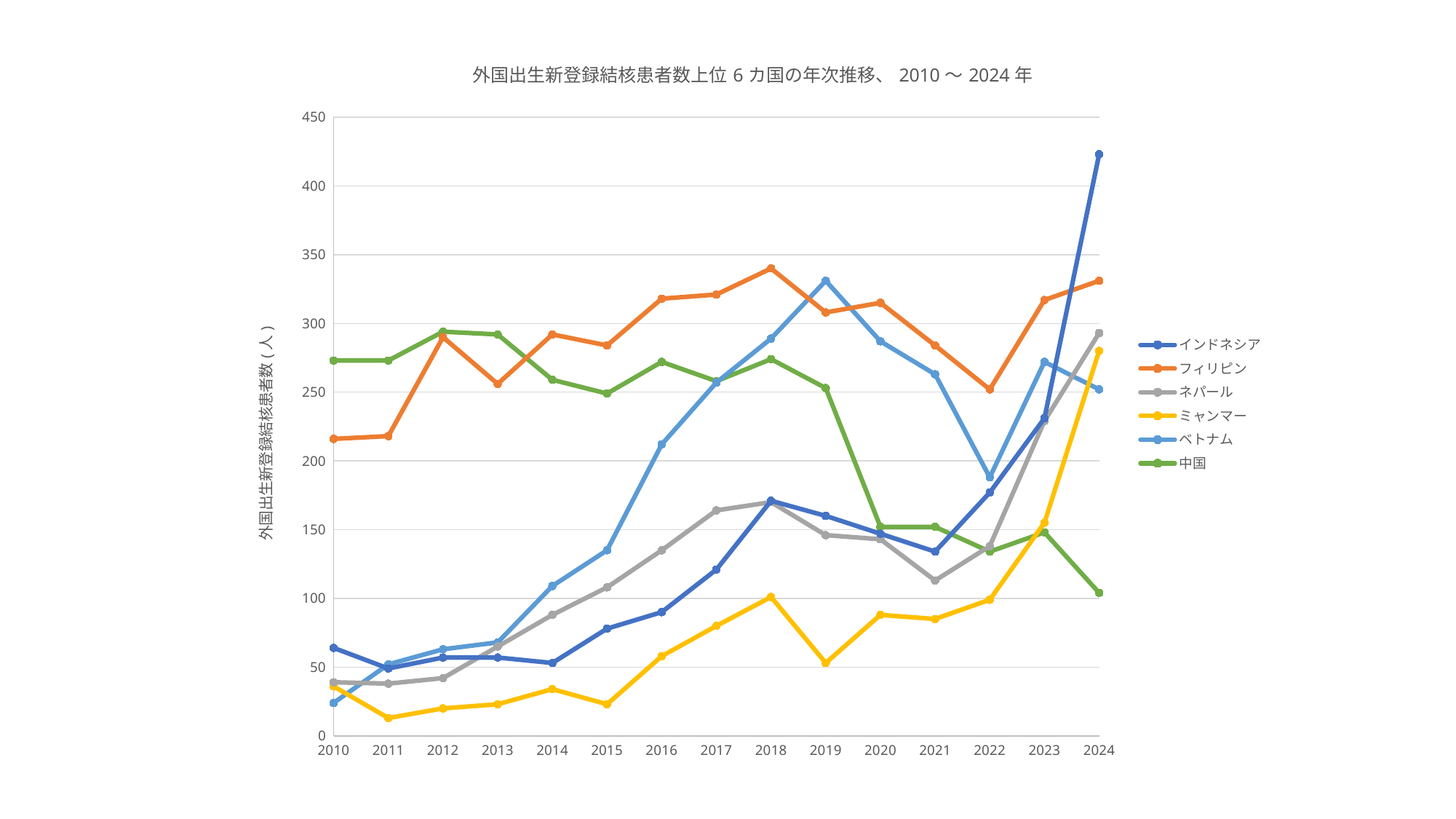
Is the value for 中国 in 2024 greater or less than 150? less Is the value for インドネシア in 2024 greater or less than 400? greater How many years are shown along the x axis? 15 Which country has the lowest value in 2024? 中国 What is the title of the chart? 外国出生新登録結核患者数上位 6 カ国の年次推移、 2010 〜 2024 年 What kind of chart is shown on the slide? line chart In 2010, which is higher, 中国 or フィリピン? 中国 Does the value for ミャンマー rise or fall from 2021 to 2024? rise Is the value for ミャンマー in 2011 greater or less than 50? less Which country has the highest value in 2024? インドネシア How many series does the legend list? 6 In which year does インドネシア reach its highest value? 2024